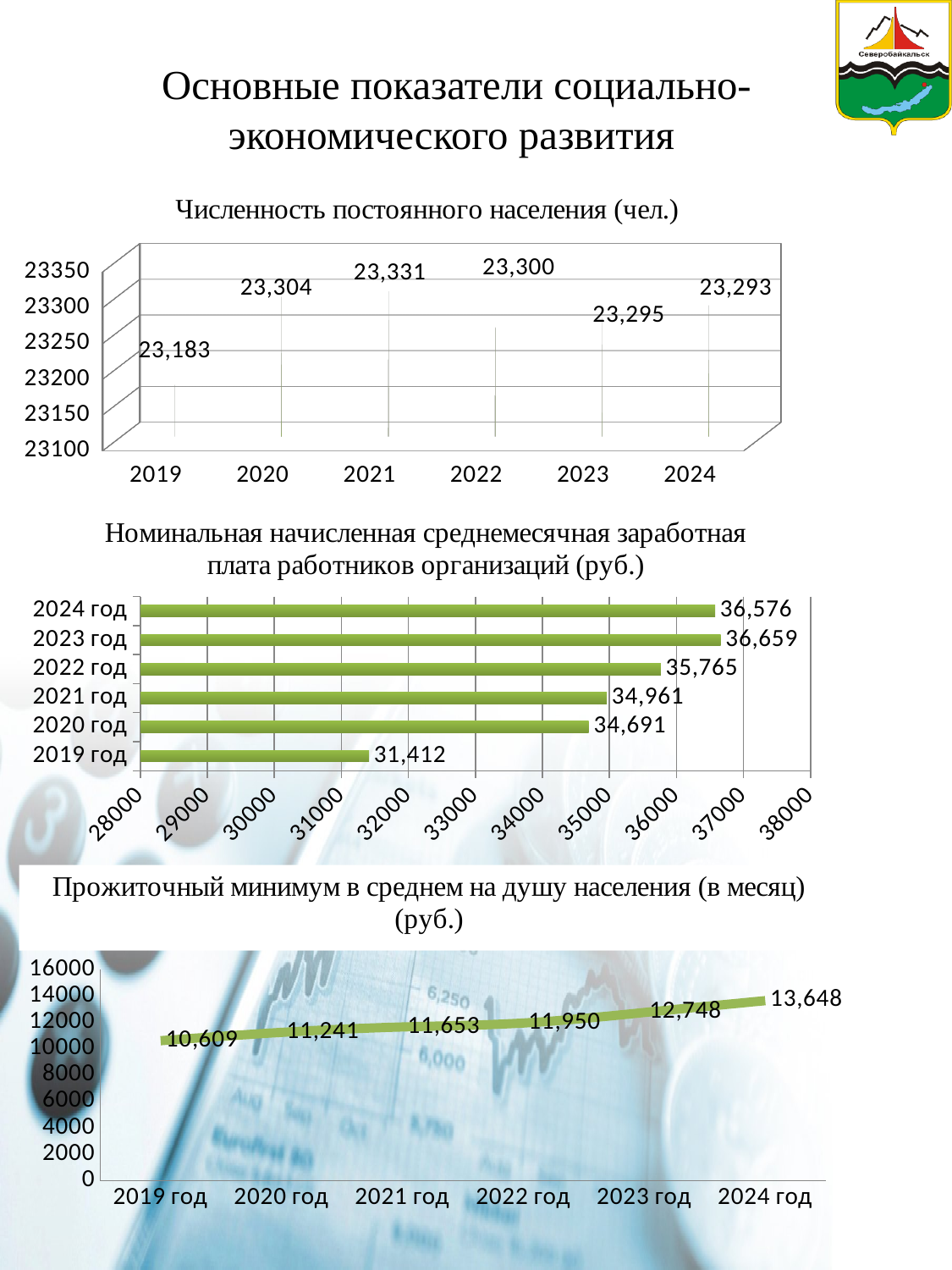
In the chart 'Номинальная начисленная среднемесячная заработная плата работников организаций (руб.)', what is the value for 2021 год? 34,961 In the chart 'Номинальная начисленная среднемесячная заработная плата работников организаций (руб.)', what is the difference between the 2024 год and 2019 год values? 5,164 What kind of chart is 'Номинальная начисленная среднемесячная заработная плата работников организаций (руб.)'? bar chart In the chart 'Номинальная начисленная среднемесячная заработная плата работников организаций (руб.)', which year has the lowest value? 2019 год In the chart 'Численность постоянного населения (чел.)', what is the value for 2019? 23,183 In the chart 'Численность постоянного населения (чел.)', how many years are shown on the x axis? 6 In the chart 'Прожиточный минимум в среднем на душу населения (в месяц) (руб.)', do the values rise or fall from 2019 год to 2024 год? rise In the chart 'Численность постоянного населения (чел.)', what is the difference between the 2021 and 2019 values? 148 In the chart 'Номинальная начисленная среднемесячная заработная плата работников организаций (руб.)', which is larger: the value for 2023 год or 2024 год? 2023 год In the chart 'Численность постоянного населения (чел.)', which year has the highest value? 2021 In the chart 'Прожиточный минимум в среднем на душу населения (в месяц) (руб.)', what is the value for 2022 год? 11,950 What kind of chart is 'Прожиточный минимум в среднем на душу населения (в месяц) (руб.)'? line chart